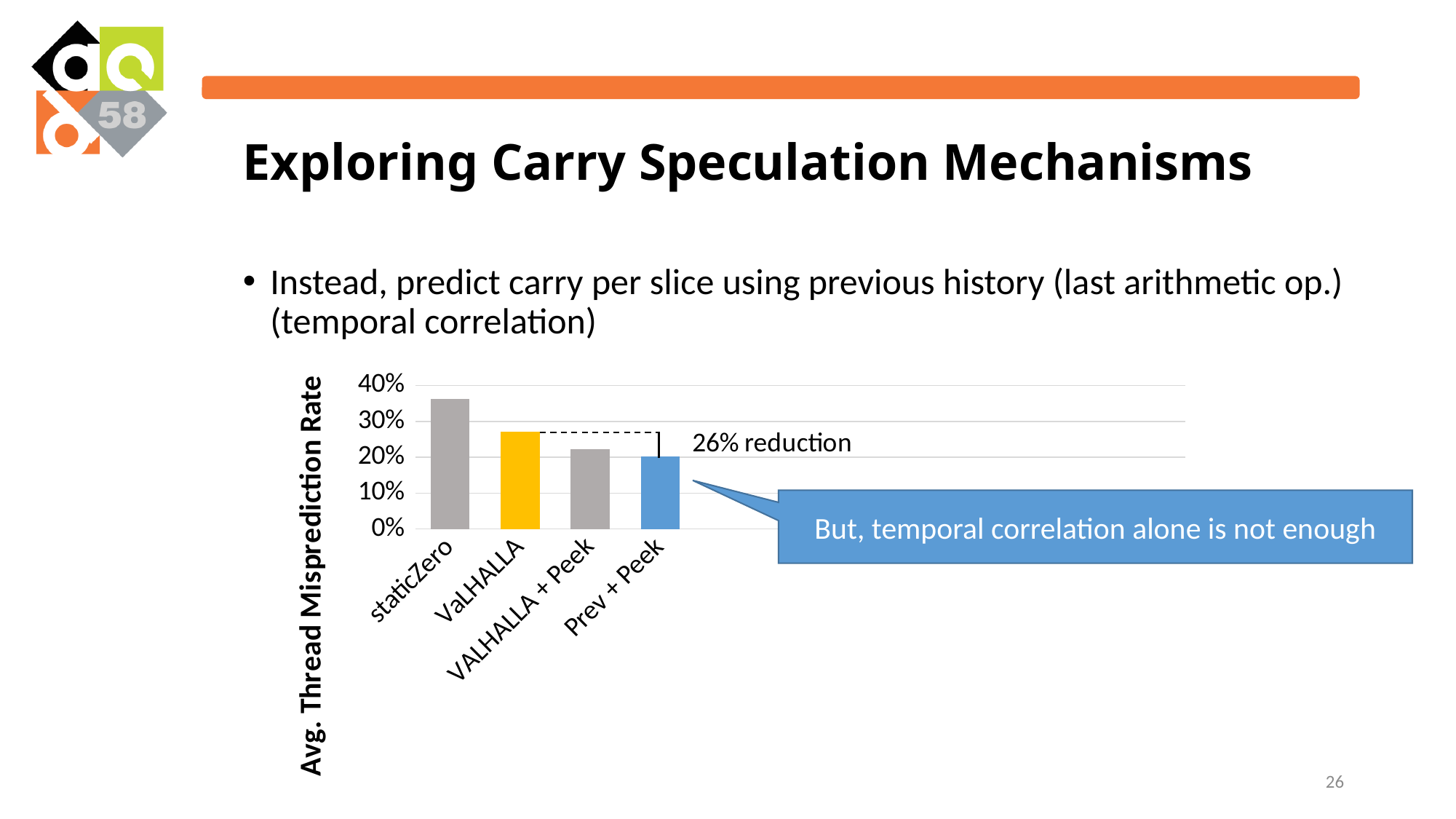
Which category has the lowest average thread misprediction rate? Prev + Peek What reduction does the annotation on the chart state between VaLHALLA and Prev + Peek? 26% reduction Is the value for VaLHALLA greater or less than 20%? greater How many categories (bars) does the chart show? 4 Which category has the highest average thread misprediction rate? staticZero Which has a higher misprediction rate, VaLHALLA or VALHALLA + Peek? VaLHALLA Is the value for Prev + Peek greater or less than 30%? less Do the bar values rise or fall from left to right across the categories? Fall Is the value for staticZero greater or less than 30%? greater What is the label on the vertical axis of the chart? Avg. Thread Misprediction Rate What kind of chart is shown on the slide? Bar chart